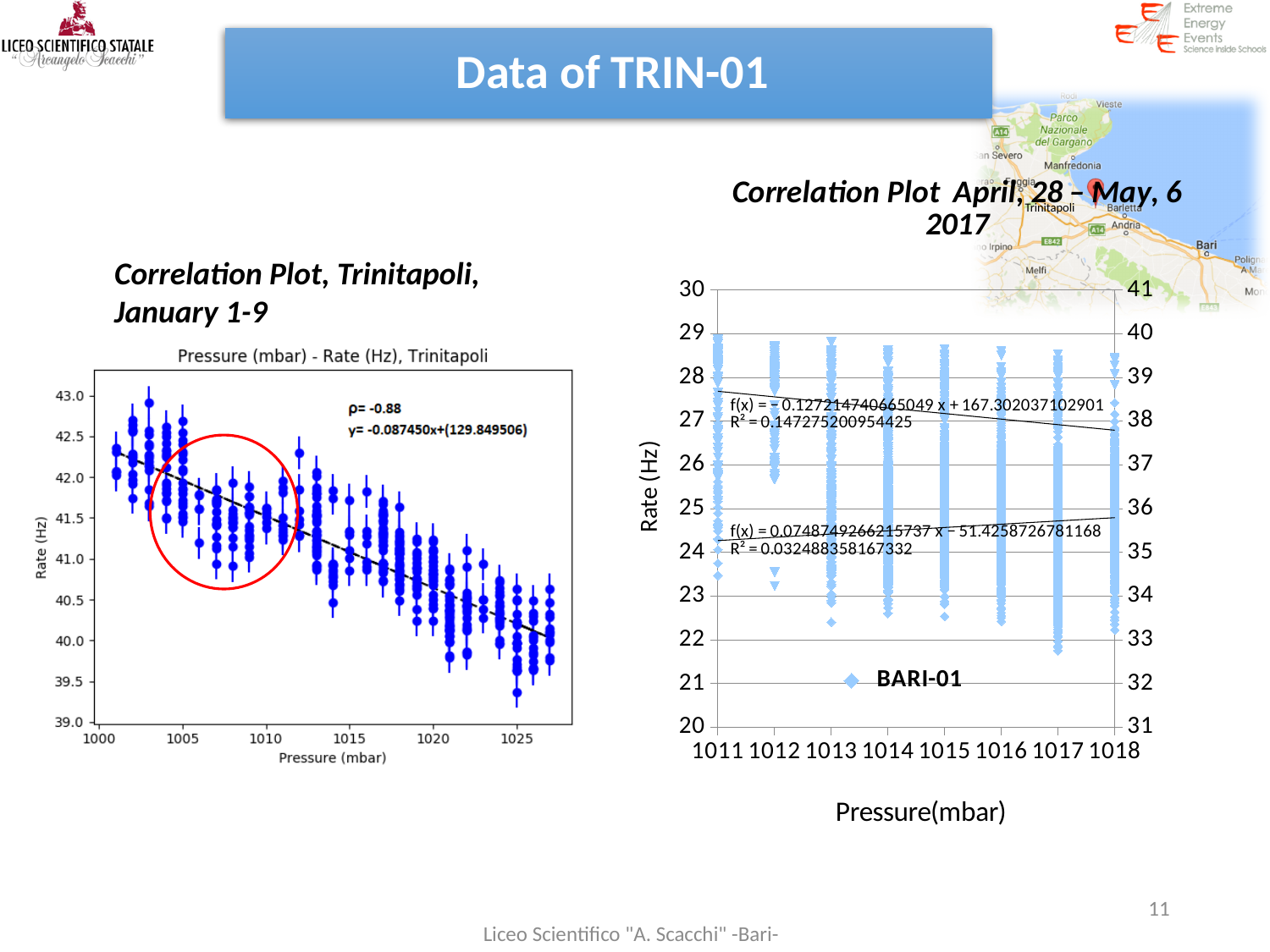
What is the name of the series shown in the legend of the right-hand chart (April 28 – May 6 2017)? BARI-01 In the left-hand chart (Trinitapoli, January 1-9), does the rate rise or fall as pressure increases? fall What is the x-axis label of the right-hand chart (April 28 – May 6 2017)? Pressure(mbar) In the right-hand chart (April 28 – May 6 2017), what is the equation printed for the lower trendline? f(x) = 0.0748749266215737 x − 51.4258726781168 In the right-hand chart (April 28 – May 6 2017), what is the R² value printed for the upper trendline? 0.147275200954425 In the left-hand chart (Trinitapoli, January 1-9), what is the fitted line equation printed on the plot? y= -0.087450x+(129.849506) What is the title printed above the left-hand chart (Trinitapoli, January 1-9)? Pressure (mbar) - Rate (Hz), Trinitapoli In the right-hand chart (April 28 – May 6 2017), what is the R² value printed for the lower trendline? 0.032488358167332 What is the highest tick value on the left y-axis (Rate (Hz)) of the right-hand chart (April 28 – May 6 2017)? 30 What kind of chart is the right-hand chart (Correlation Plot April, 28 – May, 6 2017)? scatter chart How many series does the legend of the right-hand chart (April 28 – May 6 2017) list? 1 In the left-hand chart (Correlation Plot, Trinitapoli, January 1-9), what is the correlation coefficient ρ printed on the plot? -0.88